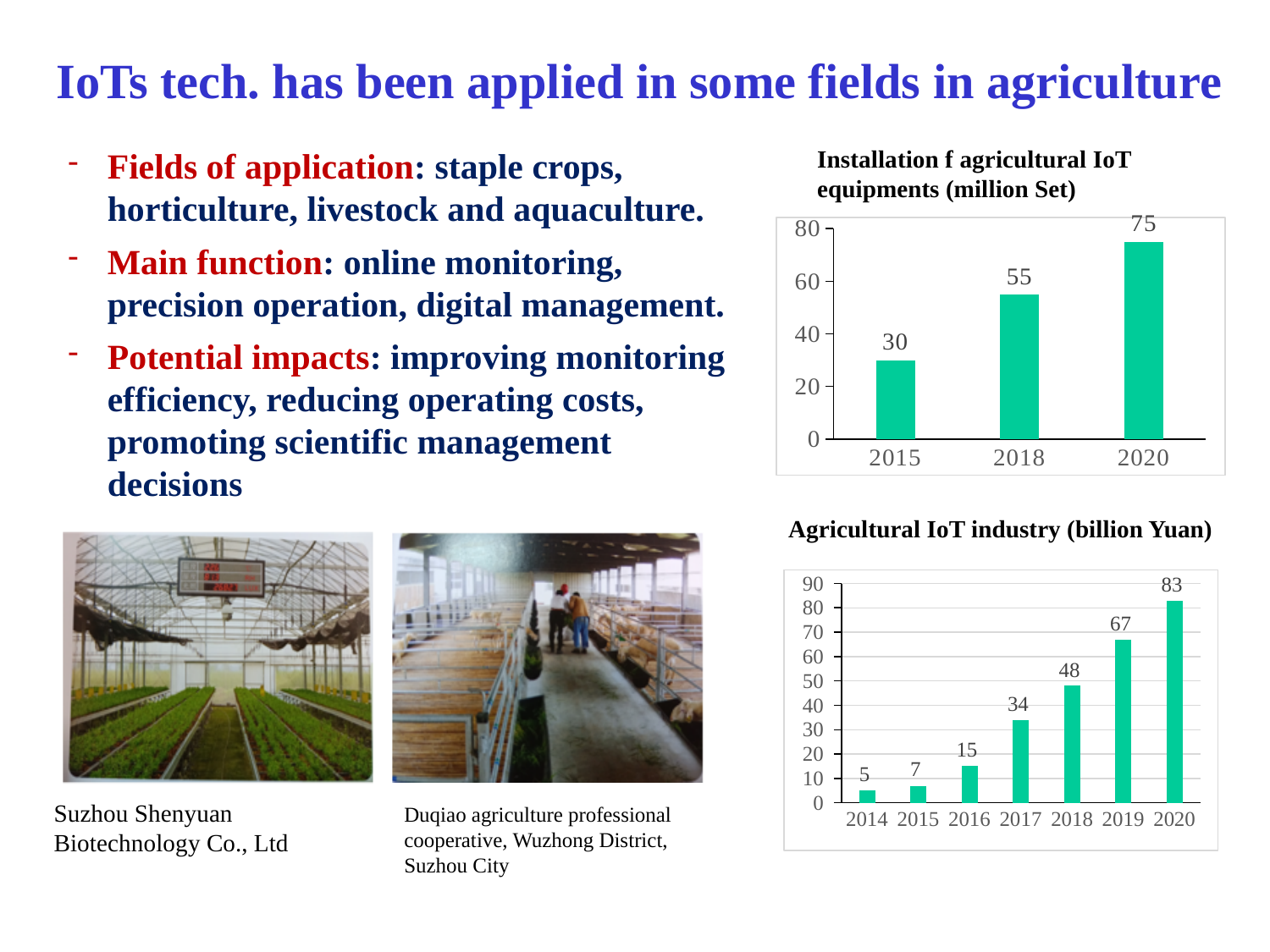
In the 'Agricultural IoT industry (billion Yuan)' chart, which year has the lowest value? 2014 In the 'Installation f agricultural IoT equipments (million Set)' chart, which year has the highest value? 2020 In the 'Agricultural IoT industry (billion Yuan)' chart, which is larger, the value for 2016 or the value for 2015? 2016 In the 'Installation f agricultural IoT equipments (million Set)' chart, what is the value for 2018? 55 How many bars are shown in the 'Installation f agricultural IoT equipments (million Set)' chart? 3 In the 'Agricultural IoT industry (billion Yuan)' chart, what is the value for 2017? 34 In the 'Agricultural IoT industry (billion Yuan)' chart, do the values rise or fall from 2014 to 2020? Rise In the 'Installation f agricultural IoT equipments (million Set)' chart, what is the difference between the 2020 and 2015 values? 45 In the 'Agricultural IoT industry (billion Yuan)' chart, what is the difference between the 2019 and 2018 values? 19 In the 'Agricultural IoT industry (billion Yuan)' chart, what is the value for 2020? 83 What kind of chart is the 'Installation f agricultural IoT equipments (million Set)' chart? Bar chart How many years are shown in the 'Agricultural IoT industry (billion Yuan)' chart? 7